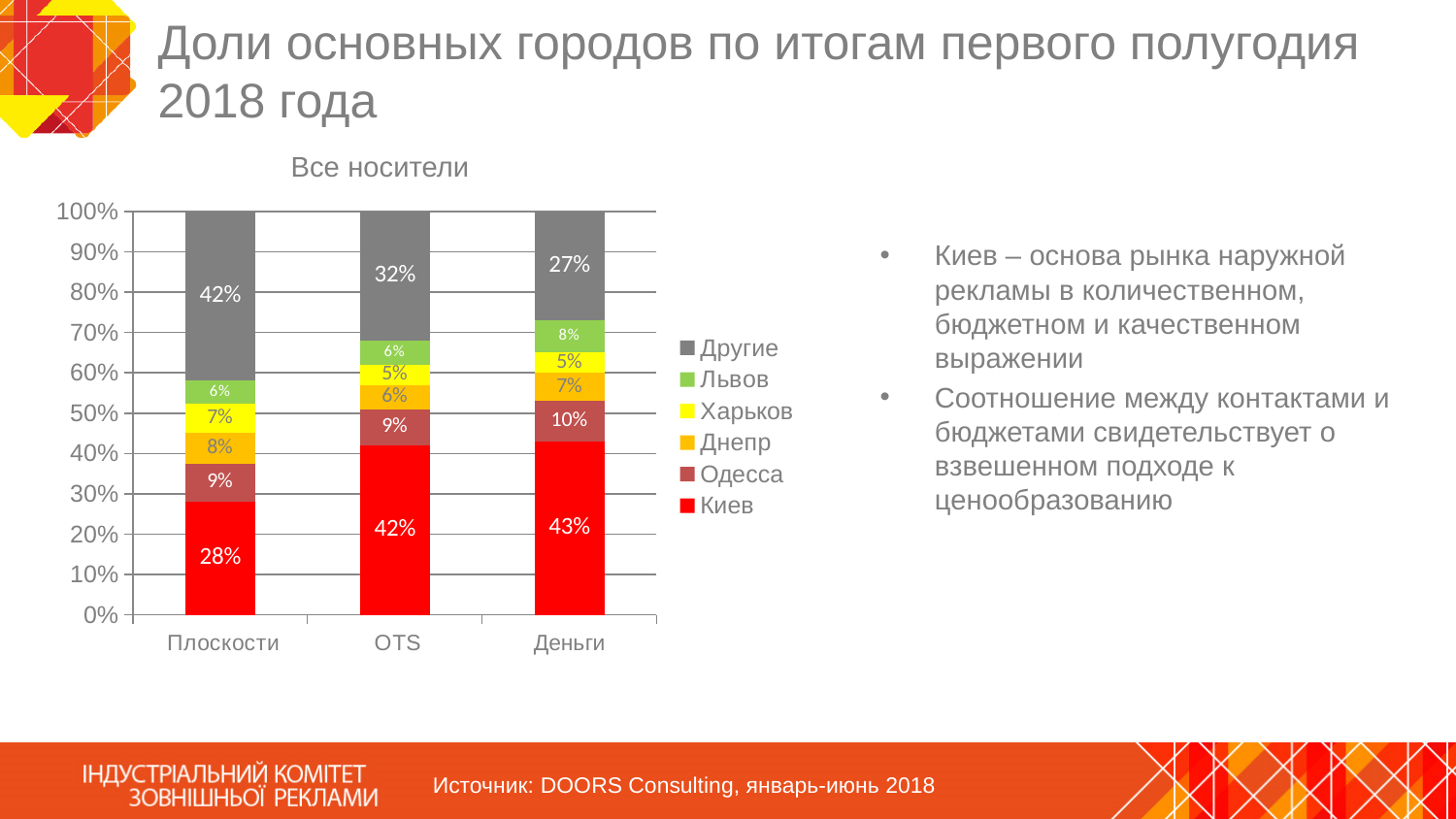
What is the value for Львов in the Деньги bar? 8% What kind of chart is shown on the slide? Stacked bar chart In which category is the Киев share the highest? Деньги In which category is the Другие share the lowest? Деньги What is the difference between the Другие value for Плоскости and the Другие value for Деньги? 15% What is the value for Одесса in the Деньги bar? 10% What is the value for Другие in the OTS bar? 32% How many categories are shown on the x axis? 3 What is the title of the chart? Все носители What is the value for Киев in the Плоскости bar? 28% Which is larger: the Киев value for OTS or the Киев value for Плоскости? OTS How many series does the legend list? 6